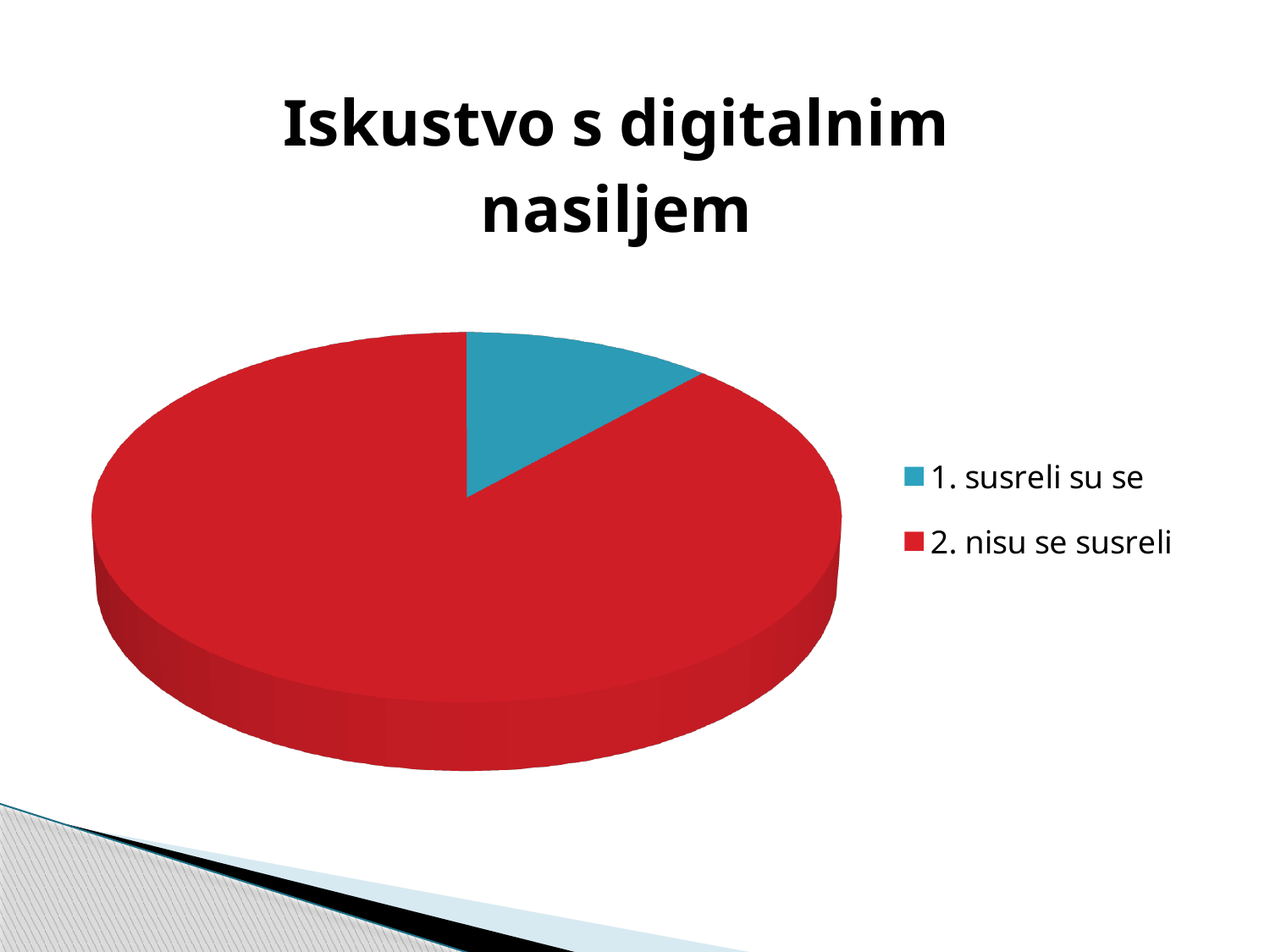
Which category has the largest slice of the pie? 2. nisu se susreli What is the title of the chart? Iskustvo s digitalnim nasiljem What colour is the slice for "1. susreli su se"? blue What kind of chart is shown on the slide? pie chart Which slice is larger, "1. susreli su se" or "2. nisu se susreli"? 2. nisu se susreli How many slices does the pie chart have? 2 How many entries does the legend list? 2 Which category has the smallest slice of the pie? 1. susreli su se